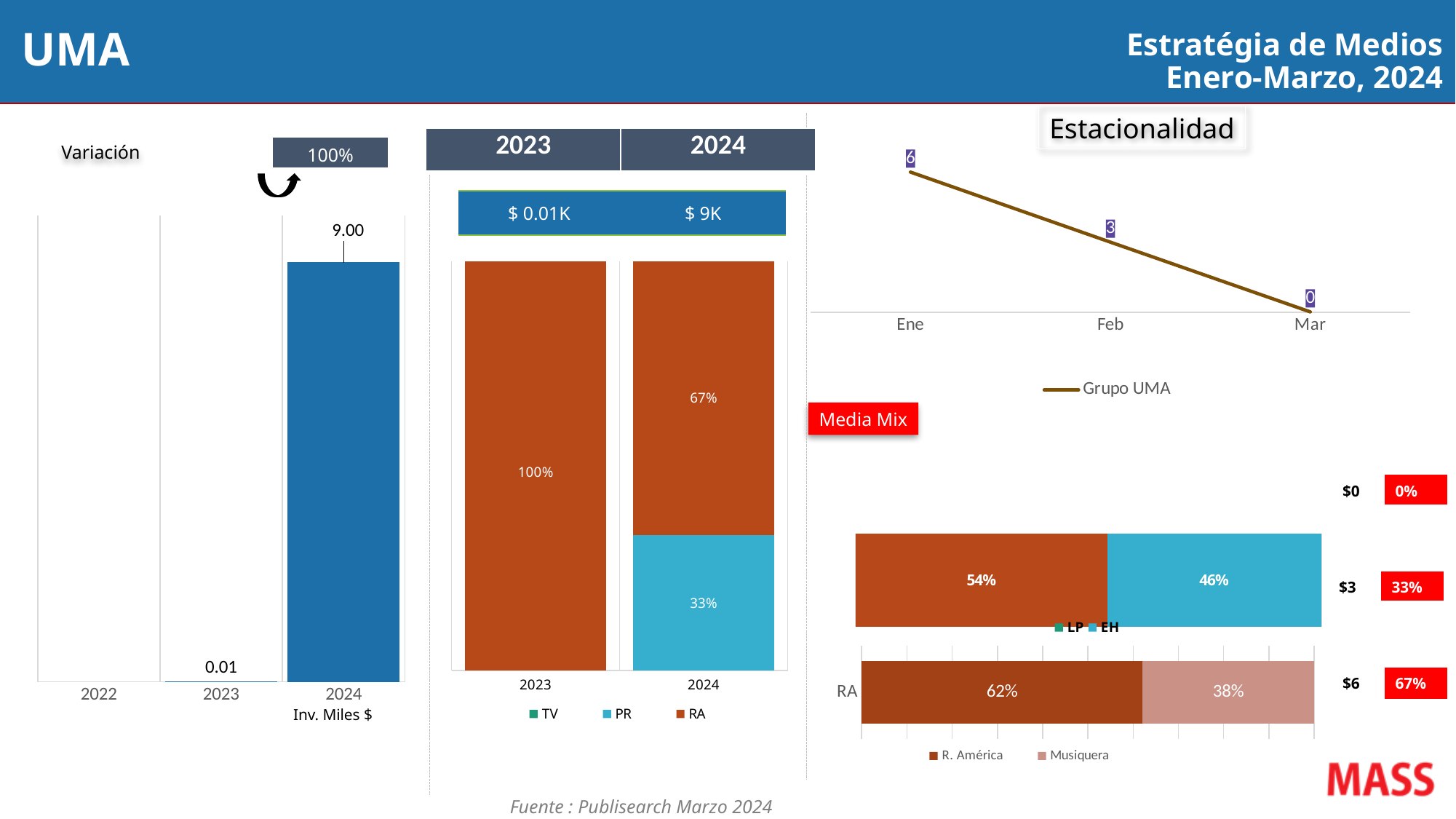
In the Estacionalidad line chart, do the values rise or fall from Ene to Mar? fall In the Estacionalidad line chart, what is the value for Grupo UMA in Ene? 6 In the stacked bar chart comparing 2023 and 2024 in the middle, what share does RA have in 2024? 67% In the stacked bar chart comparing 2023 and 2024 in the middle, how many series does the legend list? 3 In the Inv. Miles $ bar chart on the left, how many year categories are shown on the x axis? 3 In the Estacionalidad line chart, what is the value for Grupo UMA in Mar? 0 In the Estacionalidad line chart, what is the difference between the Ene and Feb values? 3 In the Media Mix RA bar at the bottom right, what share does R. América have? 62% In the stacked bar chart comparing 2023 and 2024 in the middle, what share does PR have in 2024? 33% In the Inv. Miles $ bar chart on the left, what is the value for 2024? 9.00 In the Inv. Miles $ bar chart on the left, which year has the highest value? 2024 In the Inv. Miles $ bar chart on the left, what is the value for 2023? 0.01